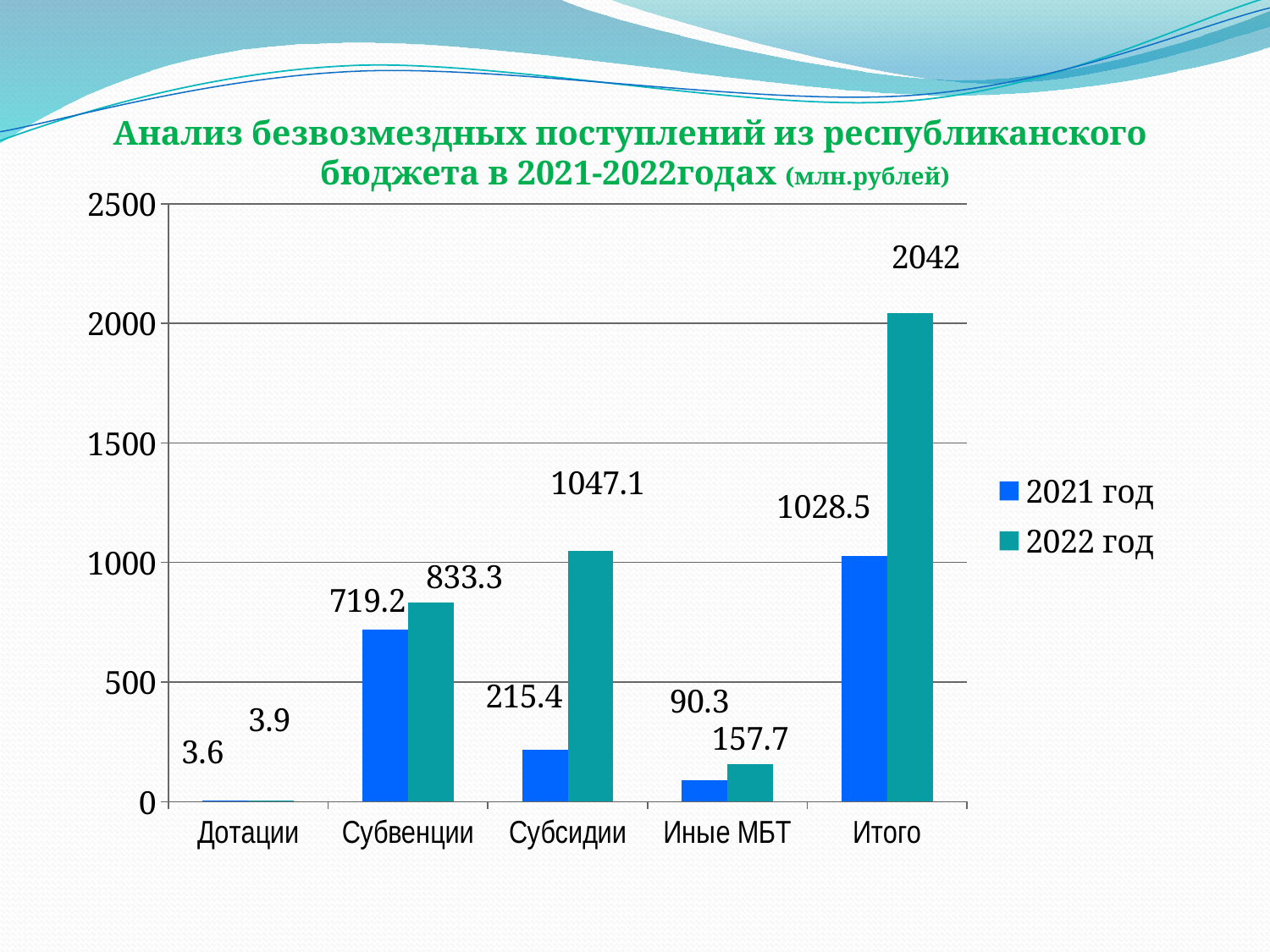
What is the difference between the 2022 год and 2021 год values for Итого? 1013.5 What is the value for Субвенции in 2021 год? 719.2 What is the value for Дотации in 2021 год? 3.6 How many series does the legend list? 2 Excluding Итого, which category has the highest value in 2022 год? Субсидии Which is larger for Субвенции: the 2021 год value or the 2022 год value? 2022 год What is the value for Субсидии in 2022 год? 1047.1 Which category has the lowest value in 2021 год? Дотации How many categories are shown on the x axis? 5 Which series is shown in blue in the legend? 2021 год What type of chart is shown on the slide? bar chart What is the value for Иные МБТ in 2022 год? 157.7